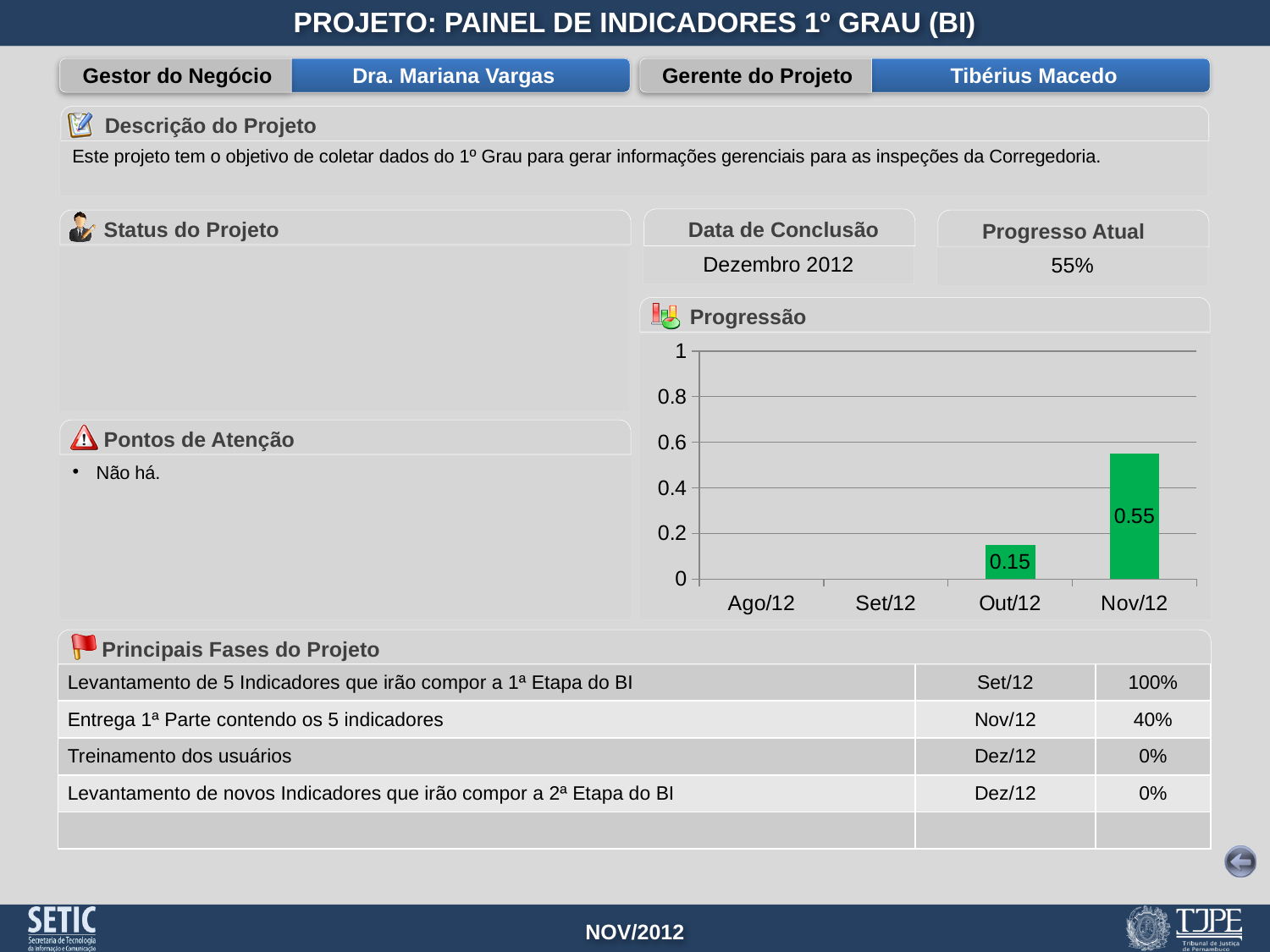
What is the value for Out/12 in the Progressão chart? 0.15 Is the value for Out/12 in the Progressão chart greater or less than 0.2? less What kind of chart is the Progressão chart? bar chart What is the maximum value shown on the y axis of the Progressão chart? 1 Is the value for Nov/12 in the Progressão chart greater or less than 0.4? greater In the Progressão chart, which is larger, the value for Out/12 or the value for Nov/12? Nov/12 How many categories are shown on the x axis of the Progressão chart? 4 What is the value for Nov/12 in the Progressão chart? 0.55 What is the title of the chart on the slide? Progressão Which category has the highest value in the Progressão chart? Nov/12 What is the difference between the Nov/12 and Out/12 values in the Progressão chart? 0.4 Do the values in the Progressão chart rise or fall from Out/12 to Nov/12? rise